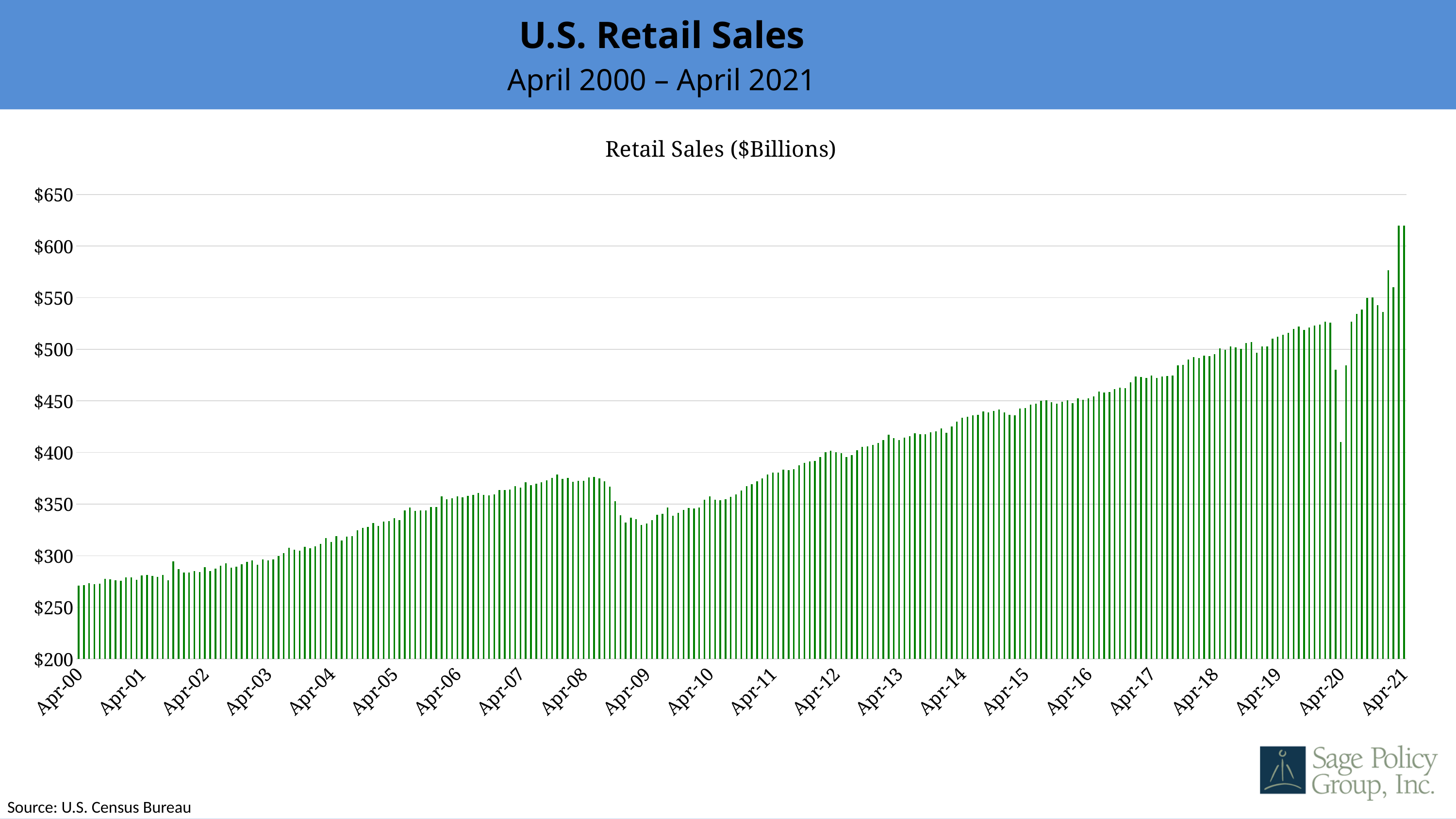
Which labelled month has the lowest retail sales value? Apr-00 How many April labels are shown on the x axis? 22 Is the value for Apr-00 greater or less than $300? less Is the value for Apr-21 greater or less than $600? greater Is the value for Apr-20 greater or less than $450? less What source is cited for the chart data? U.S. Census Bureau Which labelled month has the highest retail sales value? Apr-21 What kind of chart is shown on the slide? bar chart What is the title of the chart? Retail Sales ($Billions) Which is larger, the value for Apr-08 or the value for Apr-09? Apr-08 Overall, do retail sales rise or fall from Apr-00 to Apr-21? rise